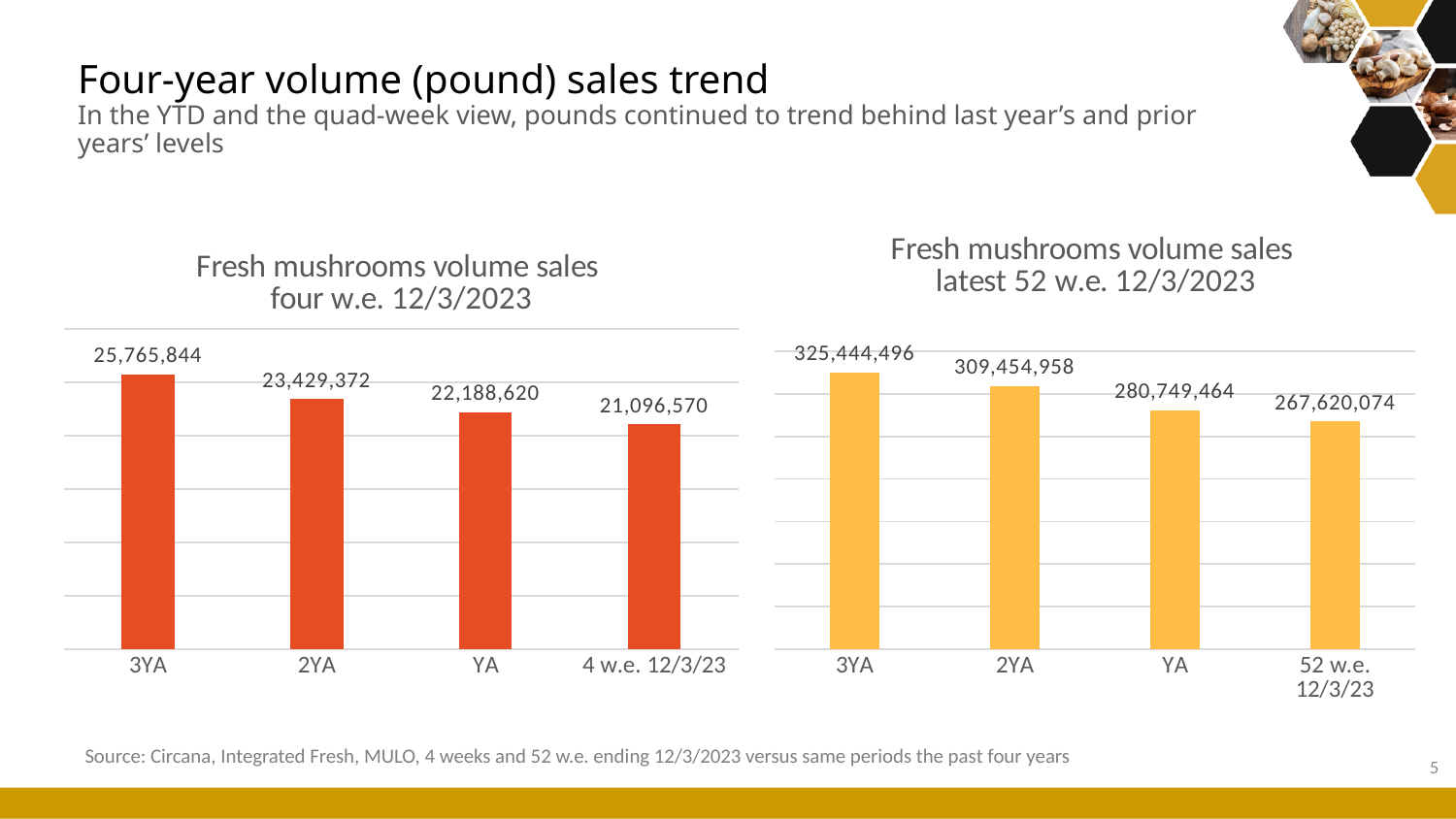
In the 'Fresh mushrooms volume sales latest 52 w.e. 12/3/2023' chart, what is the difference between the 3YA value and the 52 w.e. 12/3/23 value? 57,824,422 In the 'Fresh mushrooms volume sales latest 52 w.e. 12/3/2023' chart, what is the value for YA? 280,749,464 In the 'Fresh mushrooms volume sales four w.e. 12/3/2023' chart, what is the value for 3YA? 25,765,844 In the 'Fresh mushrooms volume sales four w.e. 12/3/2023' chart, what is the value for 4 w.e. 12/3/23? 21,096,570 In the 'Fresh mushrooms volume sales latest 52 w.e. 12/3/2023' chart, which is larger, the value for 2YA or the value for YA? 2YA In the 'Fresh mushrooms volume sales four w.e. 12/3/2023' chart, do the values rise or fall from 3YA to 4 w.e. 12/3/23? Fall In the 'Fresh mushrooms volume sales four w.e. 12/3/2023' chart, which category has the highest value? 3YA In the 'Fresh mushrooms volume sales four w.e. 12/3/2023' chart, what is the difference between the 3YA value and the 4 w.e. 12/3/23 value? 4,669,274 How many categories are shown in the 'Fresh mushrooms volume sales four w.e. 12/3/2023' chart? 4 In the 'Fresh mushrooms volume sales latest 52 w.e. 12/3/2023' chart, which category has the lowest value? 52 w.e. 12/3/23 What kind of chart is the 'Fresh mushrooms volume sales latest 52 w.e. 12/3/2023' chart? Bar chart In the 'Fresh mushrooms volume sales latest 52 w.e. 12/3/2023' chart, what is the value for 2YA? 309,454,958